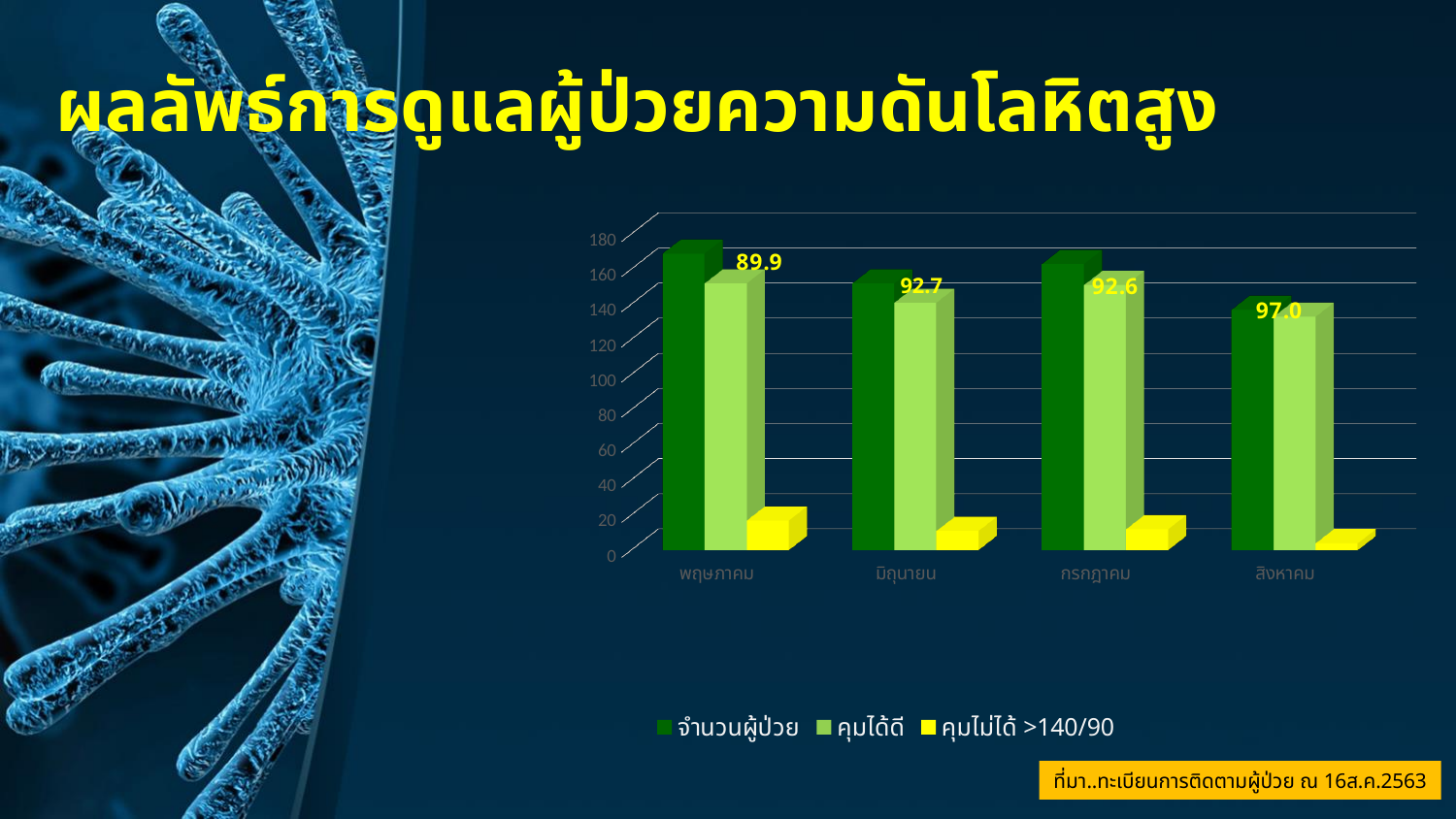
How many series does the chart legend list? 3 Is the value of the จำนวนผู้ป่วย bar for พฤษภาคม greater or less than 160? greater Which month has the highest printed data label? สิงหาคม What data label is printed for มิถุนายน? 92.7 Is the value of the คุมไม่ได้ >140/90 bar for สิงหาคม greater or less than 20? less What data label is printed for สิงหาคม? 97.0 What is the difference between the printed data labels for สิงหาคม and พฤษภาคม? 7.1 What colour represents the คุมไม่ได้ >140/90 series in the legend? yellow What data label is printed for พฤษภาคม? 89.9 What kind of chart is shown on the slide? bar chart How many months (categories) are shown on the x axis of the chart? 4 Which month has the lowest printed data label? พฤษภาคม